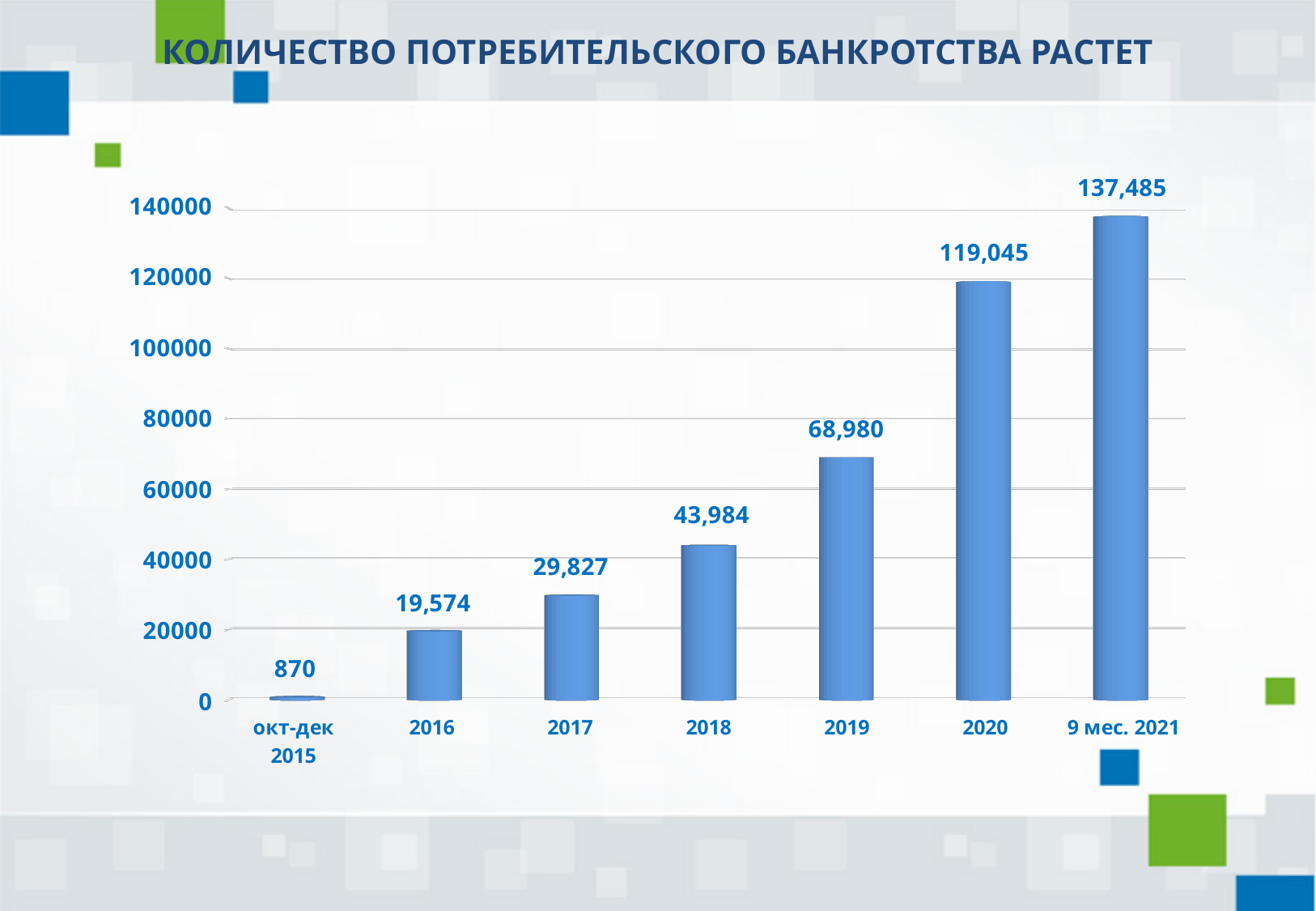
How many categories are shown on the x axis? 7 Which category has the lowest value? окт-дек 2015 Is the value for 2020 greater or less than 100000? greater What is the title of the slide? КОЛИЧЕСТВО ПОТРЕБИТЕЛЬСКОГО БАНКРОТСТВА РАСТЕТ What kind of chart is shown on the slide? bar chart What is the value for 9 мес. 2021? 137,485 Which is larger, the value for 2017 or the value for 2016? 2017 Do the values rise or fall from left to right along the x axis? rise Which category has the highest value? 9 мес. 2021 What is the value for окт-дек 2015? 870 What is the difference between the values for 2020 and 2019? 50,065 What is the value for 2018? 43,984